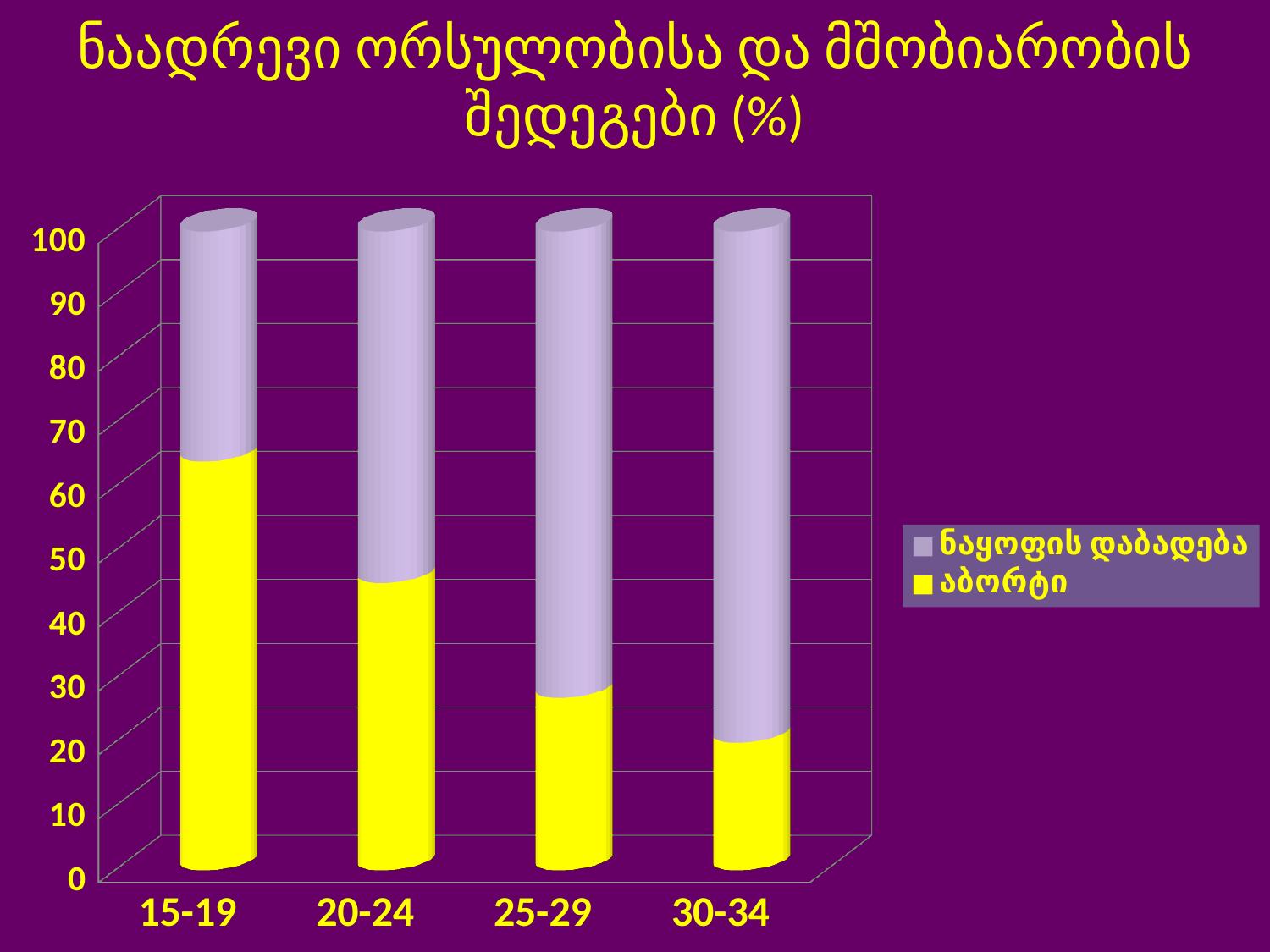
Which is larger, the აბორტი value for 15-19 or for 25-29? 15-19 Is the value for აბორტი in the 20-24 group greater or less than 40? greater How many series does the legend list? 2 Is the value for აბორტი in the 25-29 group greater or less than 40? less Is the value for აბორტი in the 30-34 group greater or less than 30? less Which age group has the highest value for აბორტი? 15-19 What kind of chart is shown on the slide? bar chart Does the აბორტი share rise or fall as the age group increases along the x axis? fall How many age-group categories are shown on the x axis? 4 Which colour represents აბორტი in the chart? yellow Which age group has the lowest value for აბორტი? 30-34